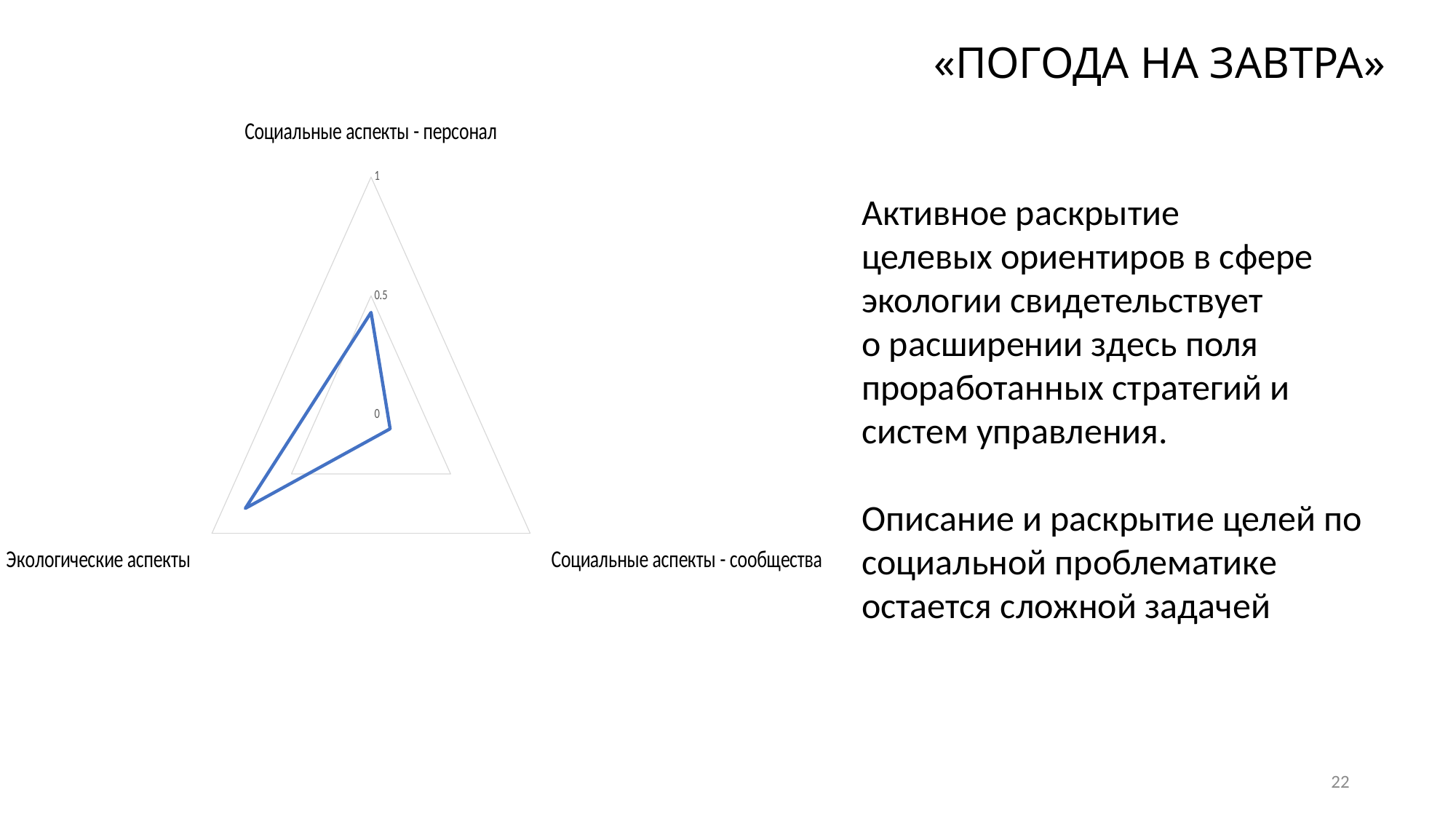
What is the maximum value shown on the radar chart's axis scale? 1 Is the value for Экологические аспекты greater or less than 0.5? greater Is the value for Социальные аспекты - персонал greater or less than 1? less Which category has the lowest value on the radar chart? Социальные аспекты - сообщества How many categories (axes) does the radar chart have? 3 Which is larger: the value for Социальные аспекты - персонал or for Социальные аспекты - сообщества? Социальные аспекты - персонал Which is larger: the value for Экологические аспекты or for Социальные аспекты - персонал? Экологические аспекты Is the value for Социальные аспекты - сообщества greater or less than 0.5? less What colour is the data line on the radar chart? blue What kind of chart is shown on the slide? radar chart Which category has the highest value on the radar chart? Экологические аспекты